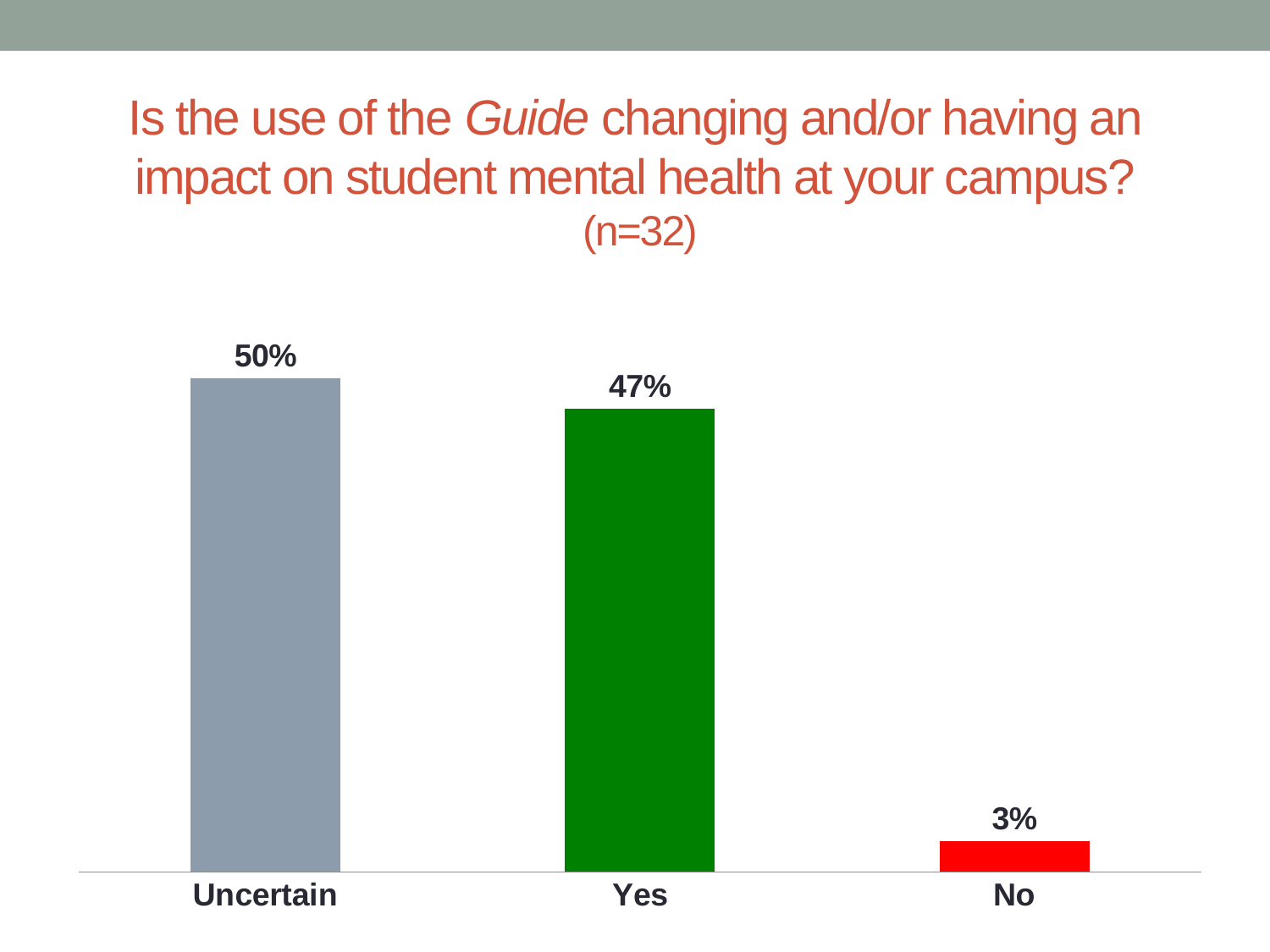
What is the difference in percentage points between "Yes" and "No"? 44 Which is larger, the percentage for "Yes" or the percentage for "No"? Yes What is the difference in percentage points between "Uncertain" and "Yes"? 3 What colour is the bar for "Yes"? Green What kind of chart is shown on the slide? Bar chart What percentage of respondents answered "Uncertain"? 50% What percentage of respondents answered "Yes"? 47% Which response category has the lowest percentage? No What percentage of respondents answered "No"? 3% How many response categories are shown in the chart? 3 Which response category has the highest percentage? Uncertain What is the sample size (n) stated in the chart title? 32